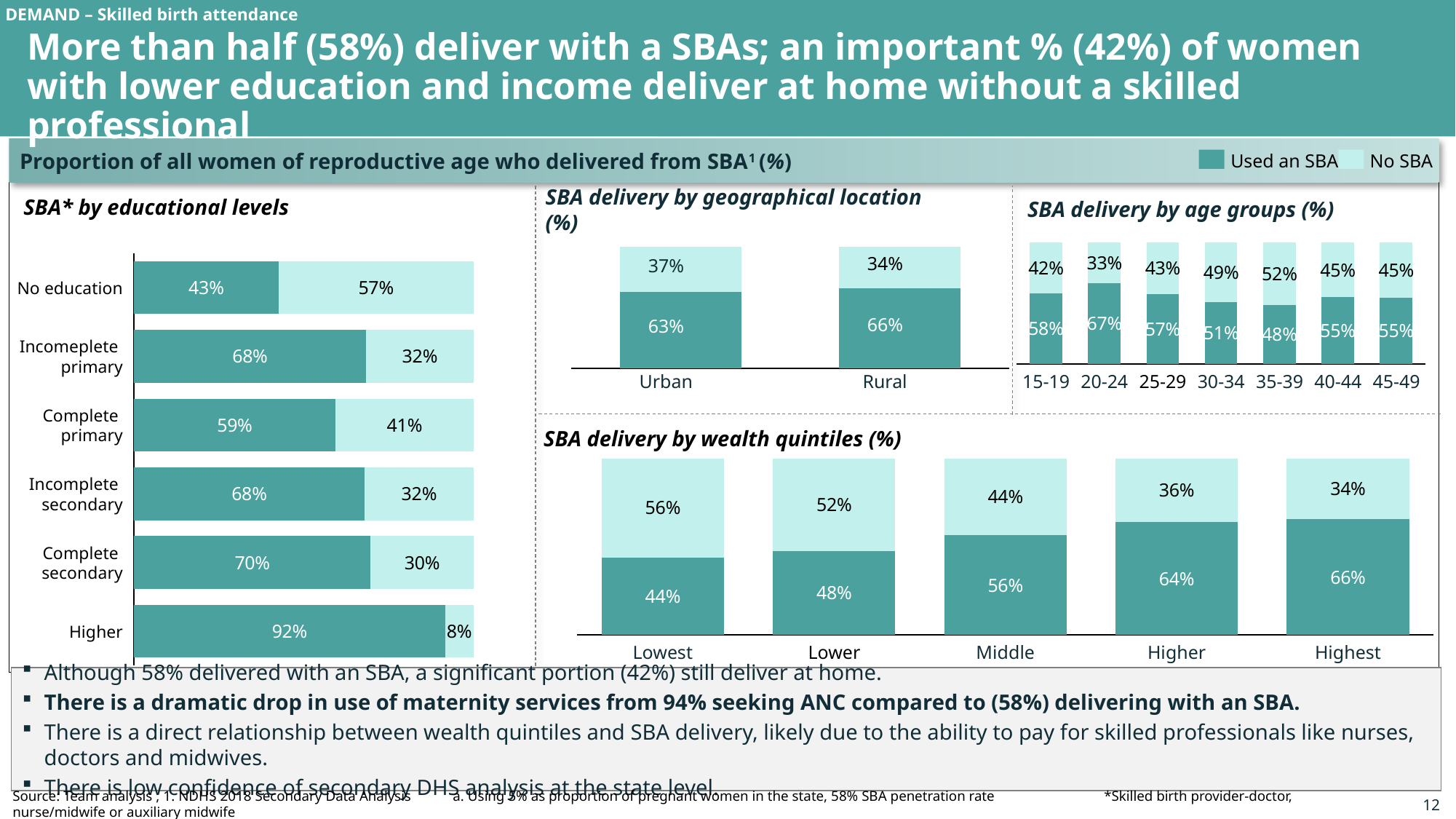
In the 'SBA delivery by age groups (%)' chart, what is the 'No SBA' value for the 35-39 age group? 52% In the 'SBA delivery by age groups (%)' chart, how many age groups are shown? 7 In the 'SBA delivery by age groups (%)' chart, which age group has the highest 'Used an SBA' value? 20-24 In the 'SBA* by educational levels' chart, what percentage of women with no education used an SBA? 43% How many series does the legend list for the charts on this slide? 2 In the 'SBA* by educational levels' chart, which educational level has the highest share of women who used an SBA? Higher In the 'SBA delivery by wealth quintiles (%)' chart, do the 'Used an SBA' values rise or fall from Lowest to Highest quintile? rise In the 'SBA delivery by geographical location (%)' chart, what is the difference between the 'Used an SBA' values for Rural and Urban? 3% In the 'SBA delivery by wealth quintiles (%)' chart, which wealth quintile has the lowest 'Used an SBA' value? Lowest In the 'SBA delivery by geographical location (%)' chart, what percentage of rural women used an SBA? 66% In the 'SBA* by educational levels' chart, what is the 'No SBA' value for the Higher education level? 8% In the 'SBA* by educational levels' chart, how many educational levels are shown? 6